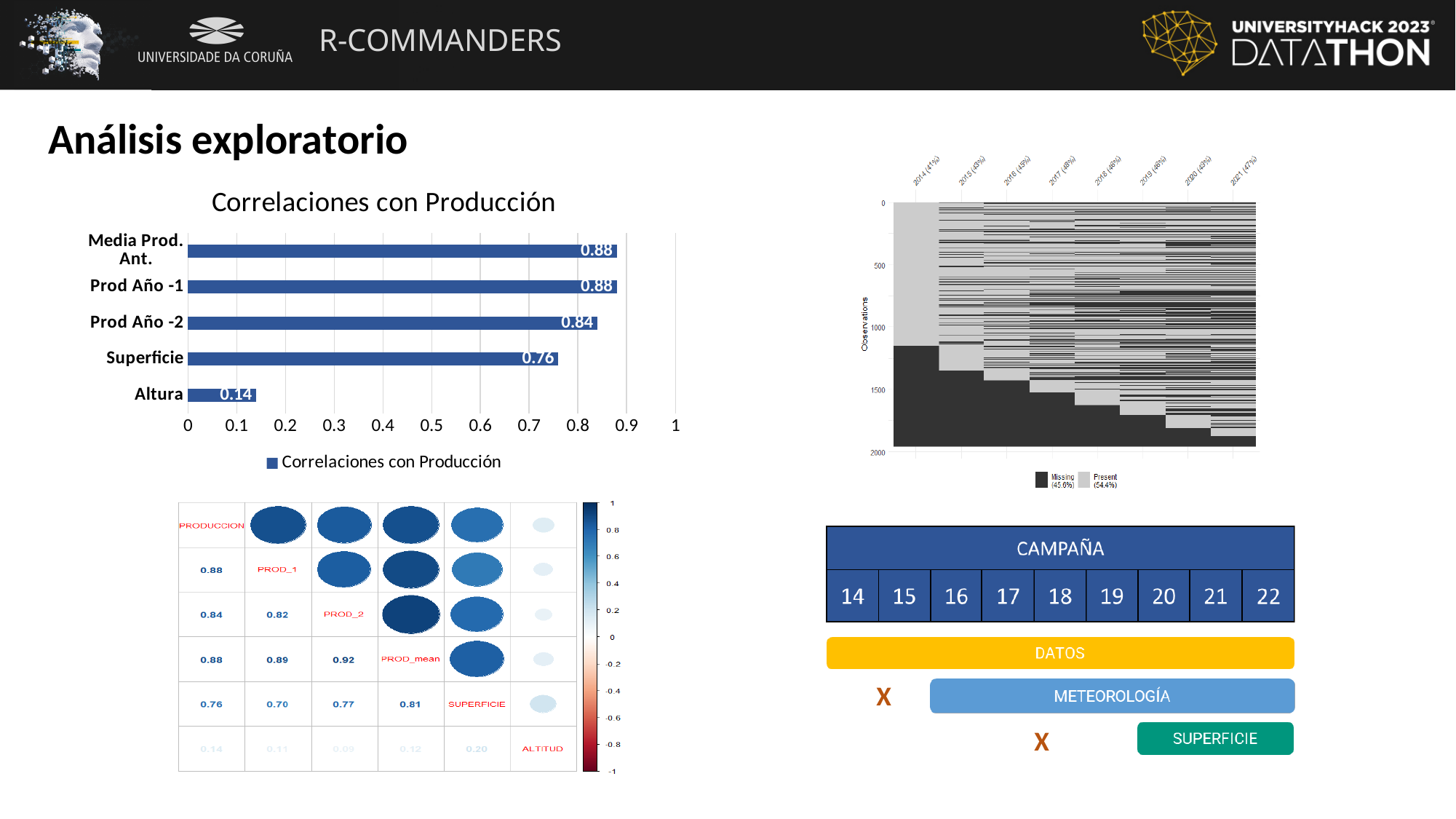
In the 'Correlaciones con Producción' bar chart, what is the value for Media Prod. Ant.? 0.88 In the 'Correlaciones con Producción' bar chart, which is larger: Prod Año -2 or Superficie? Prod Año -2 In the 'Correlaciones con Producción' bar chart, which category has the lowest value? Altura How many categories are shown in the 'Correlaciones con Producción' bar chart? 5 In the 'Correlaciones con Producción' bar chart, what is the value for Prod Año -2? 0.84 In the 'Correlaciones con Producción' bar chart, what is the difference between the values for Superficie and Altura? 0.62 In the 'Correlaciones con Producción' bar chart, what is the value for Superficie? 0.76 In the 'Correlaciones con Producción' bar chart, what is the value for Altura? 0.14 How many series does the legend of the 'Correlaciones con Producción' chart list? 1 In the 'Correlaciones con Producción' bar chart, is the value for Superficie greater or less than 0.7? greater What kind of chart is 'Correlaciones con Producción'? bar chart In the 'Correlaciones con Producción' bar chart, what is the difference between the values for Prod Año -1 and Prod Año -2? 0.04